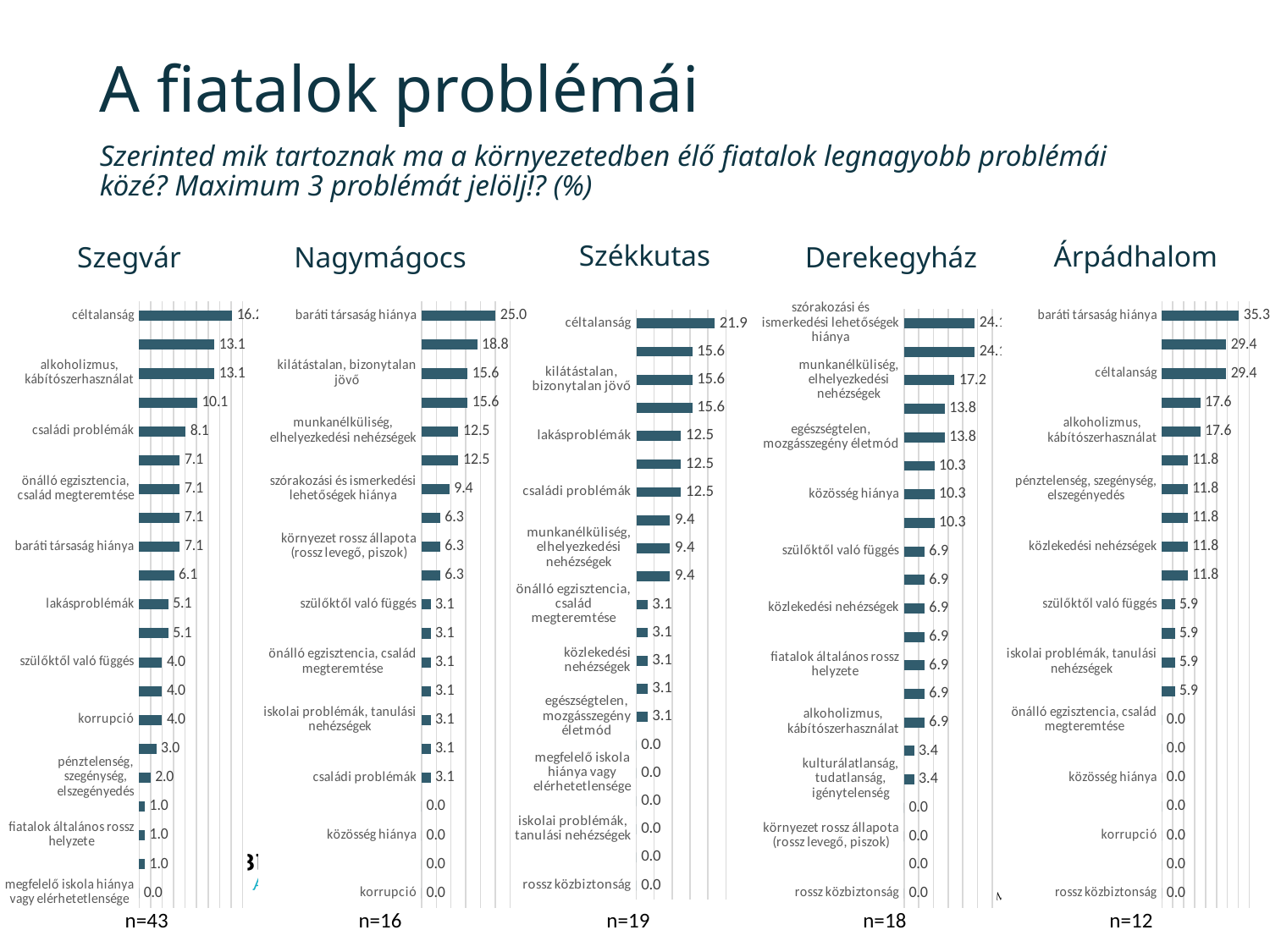
In the Derekegyház chart, what is the value for kulturálatlanság, tudatlanság, igénytelenség? 3.4 In the Székkutas chart, what is the difference between céltalanság and lakásproblémák? 9.4 In the Székkutas chart, what is the value for céltalanság? 21.9 What kind of chart is used for the Szegvár data? bar chart In the Derekegyház chart, what is the value for munkanélküliség, elhelyezkedési nehézségek? 17.2 In the Szegvár chart, what is the value for családi problémák? 8.1 In the Nagymágocs chart, what is the value for baráti társaság hiánya? 25.0 In the Árpádhalom chart, which category has the highest value? baráti társaság hiánya How many separate bar charts are shown on the slide? 5 In the Árpádhalom chart, what is the value for alkoholizmus, kábítószerhasználat? 17.6 In the Nagymágocs chart, which is larger: munkanélküliség, elhelyezkedési nehézségek or szülőktől való függés? munkanélküliség, elhelyezkedési nehézségek In the Árpádhalom chart, what is the difference between baráti társaság hiánya and céltalanság? 5.9